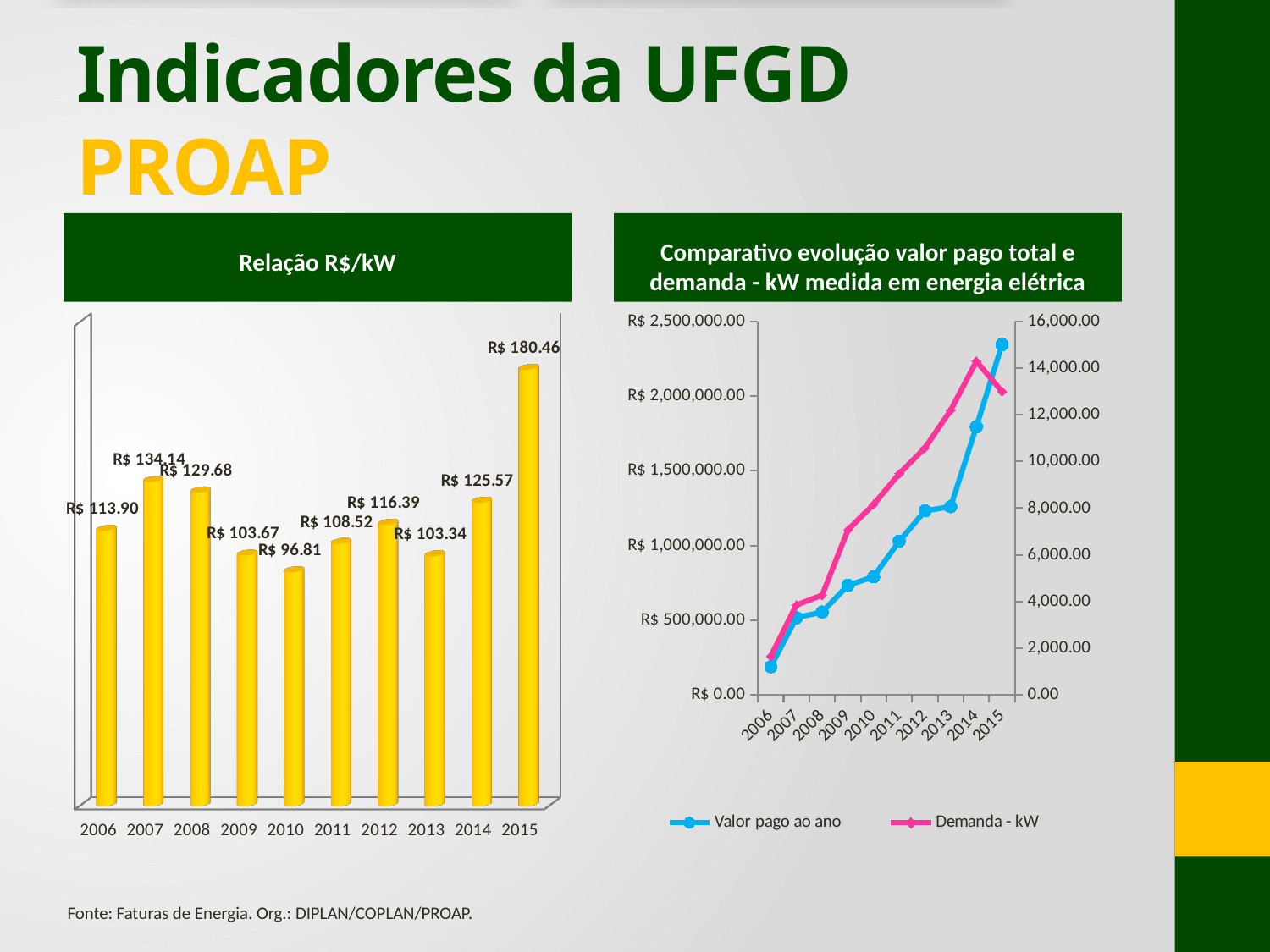
In the 'Relação R$/kW' chart, which is larger, the value for 2007 or the value for 2008? 2007 In the 'Relação R$/kW' chart, what is the value for 2015? R$ 180.46 In the 'Relação R$/kW' chart, which year has the lowest value? 2010 In the 'Relação R$/kW' chart, what is the difference between the values for 2015 and 2014? R$ 54.89 In the 'Relação R$/kW' chart, what is the value for 2010? R$ 96.81 In the 'Comparativo evolução valor pago total e demanda' chart, which series is drawn in pink? Demanda - kW How many series does the legend of the 'Comparativo evolução valor pago total e demanda' chart list? 2 In the 'Relação R$/kW' chart, which year has the highest value? 2015 In the 'Comparativo evolução valor pago total e demanda' chart, is the value of 'Valor pago ao ano' for 2015 greater or less than R$ 2,000,000.00? greater In the 'Comparativo evolução valor pago total e demanda' chart, does 'Demanda - kW' generally rise or fall from 2006 to 2014? rise What kind of chart is the 'Relação R$/kW' chart? Bar chart How many years are shown in the 'Relação R$/kW' chart? 10